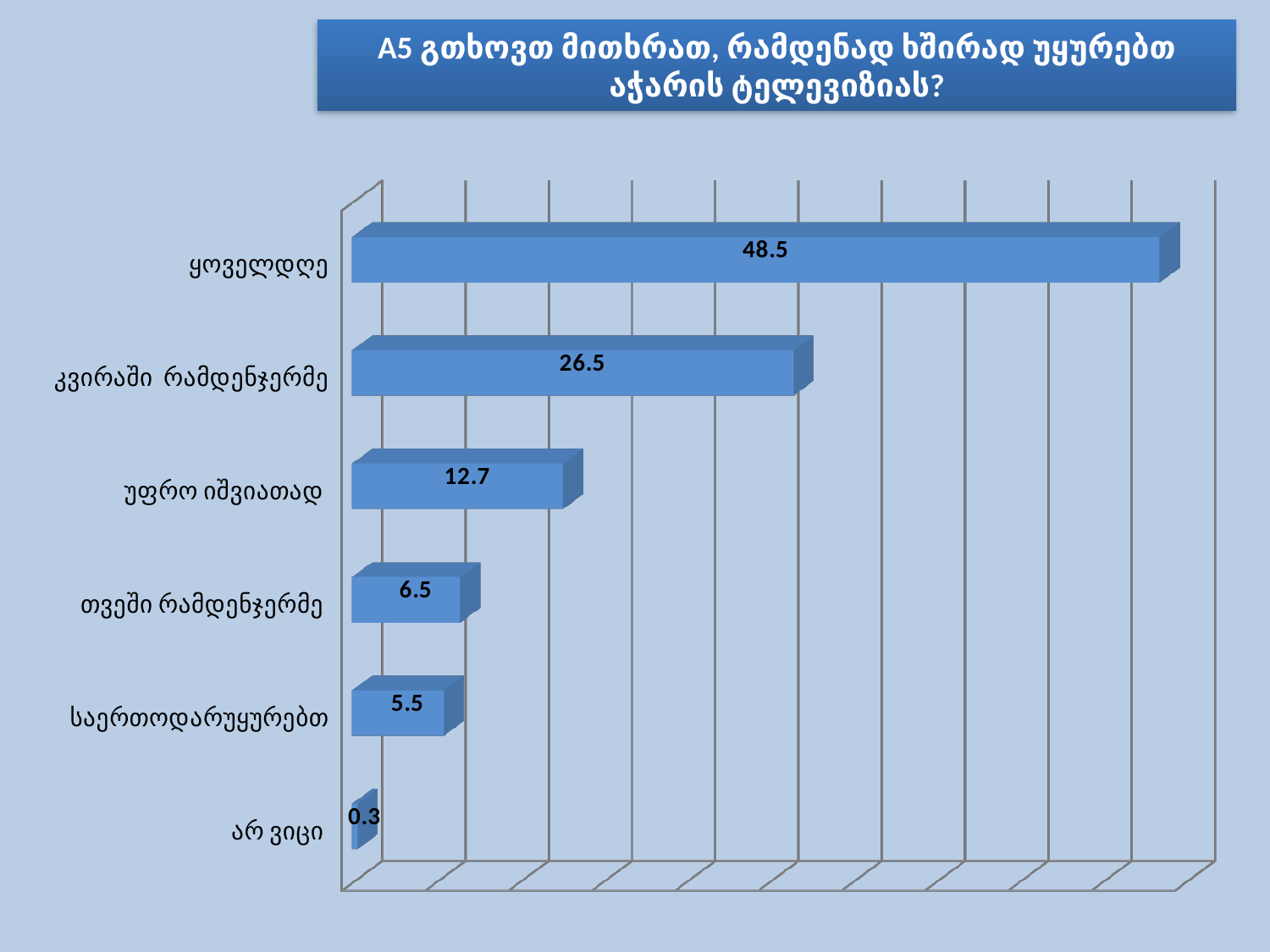
What kind of chart is shown on the slide? bar chart What value is shown for ყოველდღე? 48.5 What value is shown for უფრო იშვიათად? 12.7 What value is shown for თვეში რამდენჯერმე? 6.5 Which is larger, the value for თვეში რამდენჯერმე or the value for საერთოდარუყურებთ? თვეში რამდენჯერმე Which category has the highest value? ყოველდღე Which category has the lowest value? არ ვიცი What is the difference between the values for ყოველდღე and კვირაში რამდენჯერმე? 22 How many categories are shown in the chart? 6 What value is shown for არ ვიცი? 0.3 What value is shown for კვირაში რამდენჯერმე? 26.5 What is the difference between the values for უფრო იშვიათად and თვეში რამდენჯერმე? 6.2